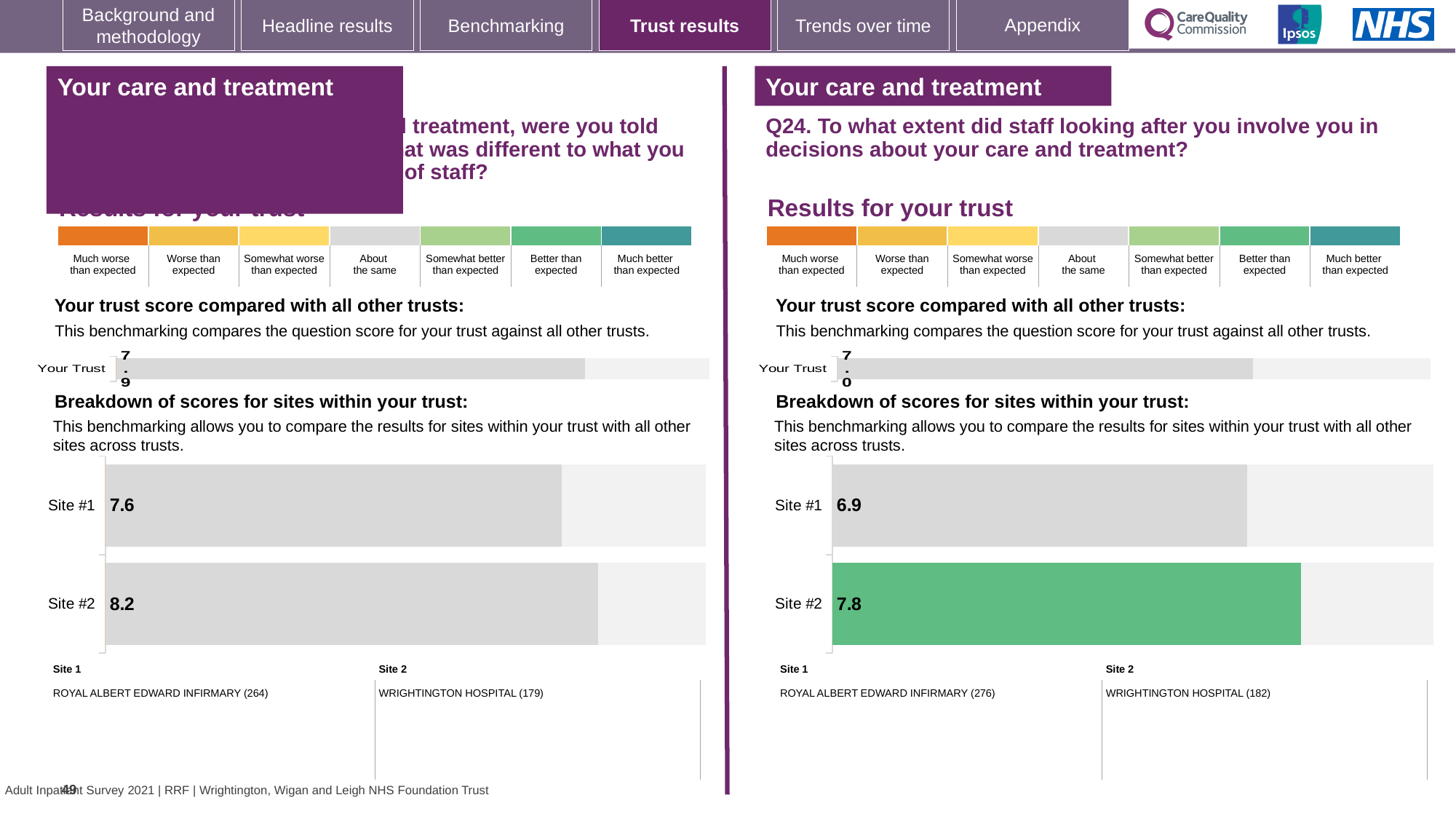
In the site breakdown chart on the right (Q24), what is the score for Site #2? 7.8 In the site breakdown chart on the right (Q24), what is the difference between the Site #2 and Site #1 scores? 0.9 How many sites are shown in the site breakdown chart on the right (Q24)? 2 In the site breakdown chart on the left side of the slide, which site has the lower score? Site #1 In the site breakdown chart on the right (Q24), what is the score for Site #1? 6.9 In the 'Your Trust' chart on the left side of the slide, what is the trust score? 7.9 In the site breakdown chart on the left side of the slide, what is the difference between the Site #2 and Site #1 scores? 0.6 In the 'Your Trust' chart on the right (Q24), what is the trust score? 7.0 In the site breakdown chart on the left side of the slide, what is the score for Site #2? 8.2 In the site breakdown chart on the left side of the slide, what is the score for Site #1? 7.6 In the site breakdown chart on the right (Q24), which site has the higher score? Site #2 What type of chart is used for the site breakdown on the right (Q24)? Bar chart